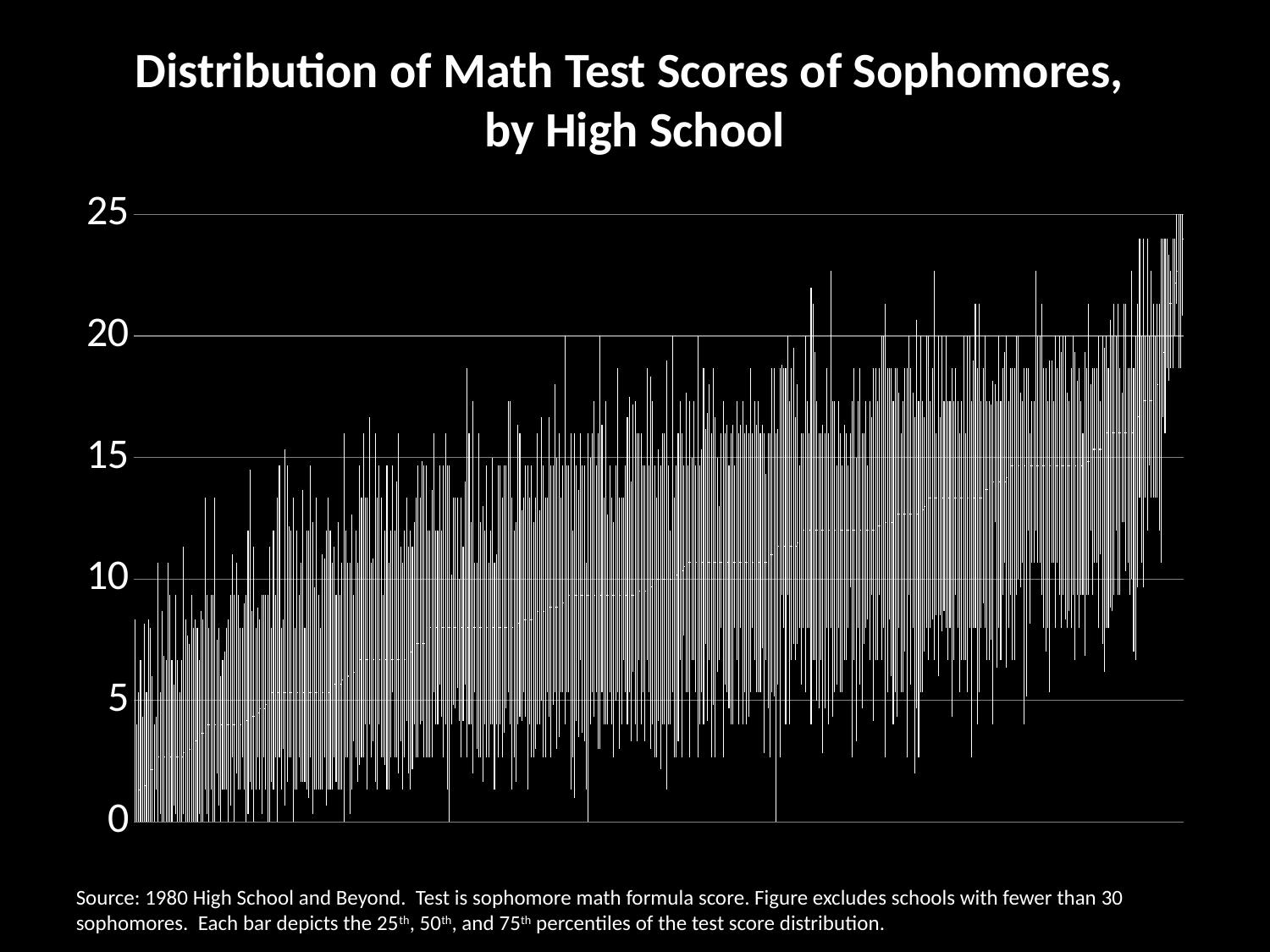
Do the bar heights generally rise or fall moving from left to right along the x axis? rise What is the highest value labelled on the vertical axis? 25 What is the title of the chart? Distribution of Math Test Scores of Sophomores, by High School What kind of chart is shown on the slide? bar chart